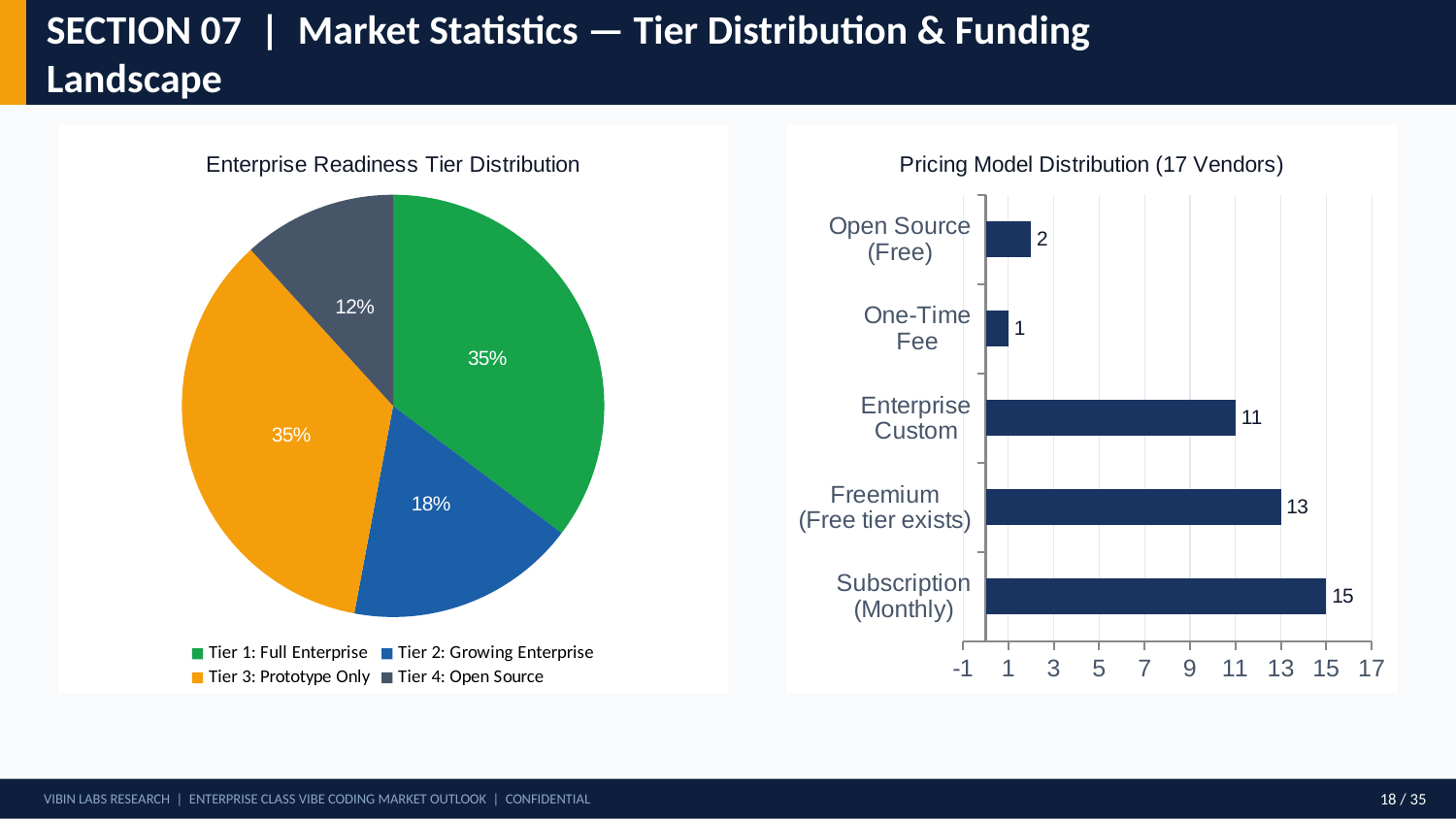
In the Enterprise Readiness Tier Distribution pie chart, what share does Tier 2: Growing Enterprise have? 18% In the Pricing Model Distribution chart, what is the difference between the Freemium (Free tier exists) and Enterprise Custom values? 2 In the Pricing Model Distribution chart, which is larger: Open Source (Free) or One-Time Fee? Open Source (Free) In the Enterprise Readiness Tier Distribution pie chart, which tier has the smallest share? Tier 4: Open Source In the Pricing Model Distribution chart, what is the value for Enterprise Custom? 11 How many entries does the legend of the Enterprise Readiness Tier Distribution chart list? 4 In the Enterprise Readiness Tier Distribution pie chart, what colour is the Tier 3: Prototype Only slice? Orange How many pricing model categories are shown in the Pricing Model Distribution chart? 5 In the Pricing Model Distribution chart, which pricing model has the lowest value? One-Time Fee In the Pricing Model Distribution chart, which pricing model has the highest value? Subscription (Monthly) In the Pricing Model Distribution chart, how many vendors use a Subscription (Monthly) pricing model? 15 What type of chart is the Pricing Model Distribution chart? Bar chart